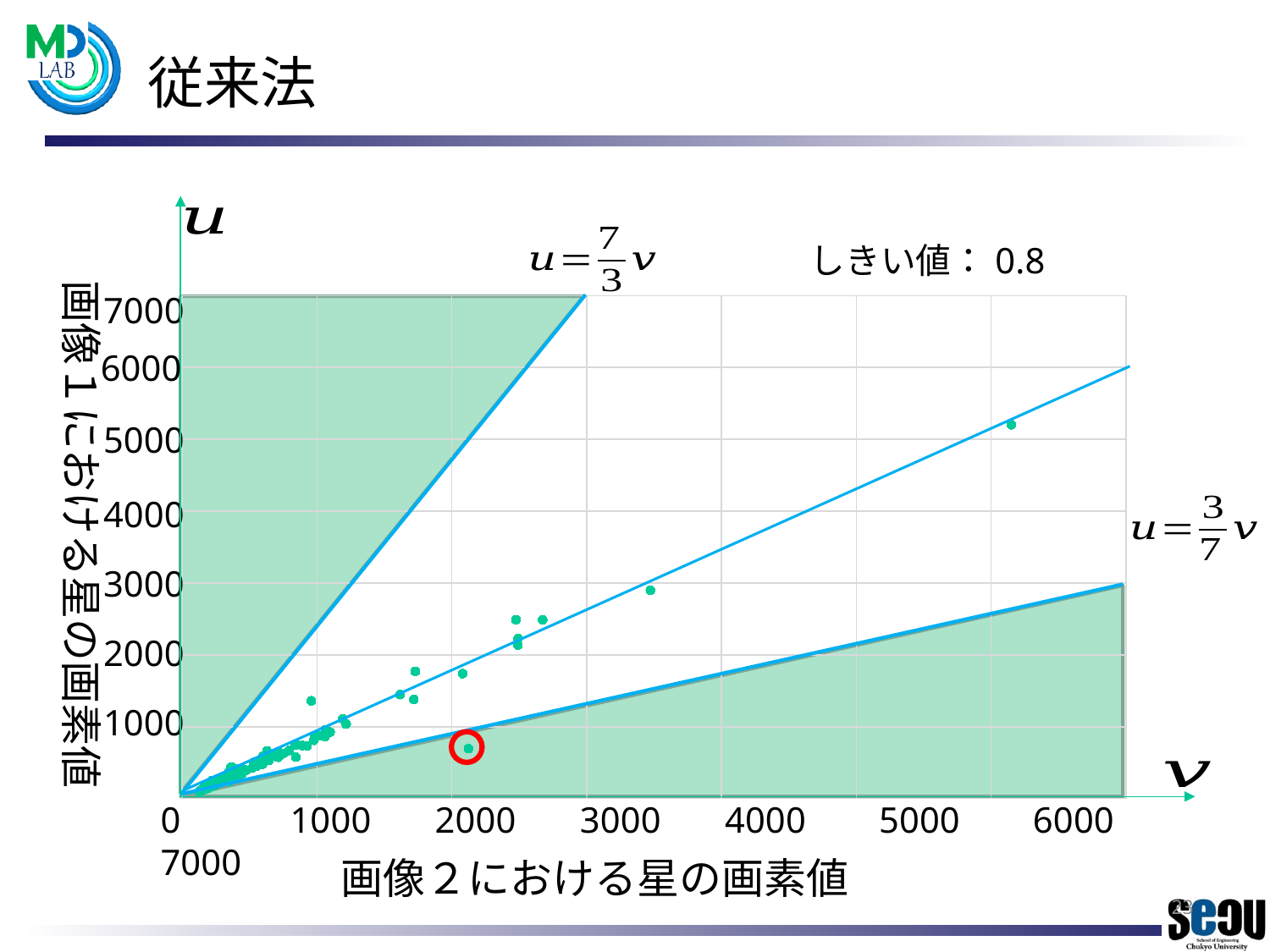
What is the title of the vertical axis of the chart? 画像１における星の画素値 What is the title of the horizontal axis of the chart? 画像２における星の画素値 Is the v value of the point marked with a red circle greater or less than 1000? greater Do the plotted points generally rise or fall as v increases? rise Is the v value of the rightmost plotted point greater or less than 5000? greater Is the u value of the point marked with a red circle greater or less than 1000? less What threshold value (しきい値) is stated on the slide? 0.8 Which plotted point has the highest u value: the rightmost point or the point marked with a red circle? the rightmost point What kind of chart is shown on the slide? scatter chart What is the largest tick value shown on the vertical (u) axis? 7000